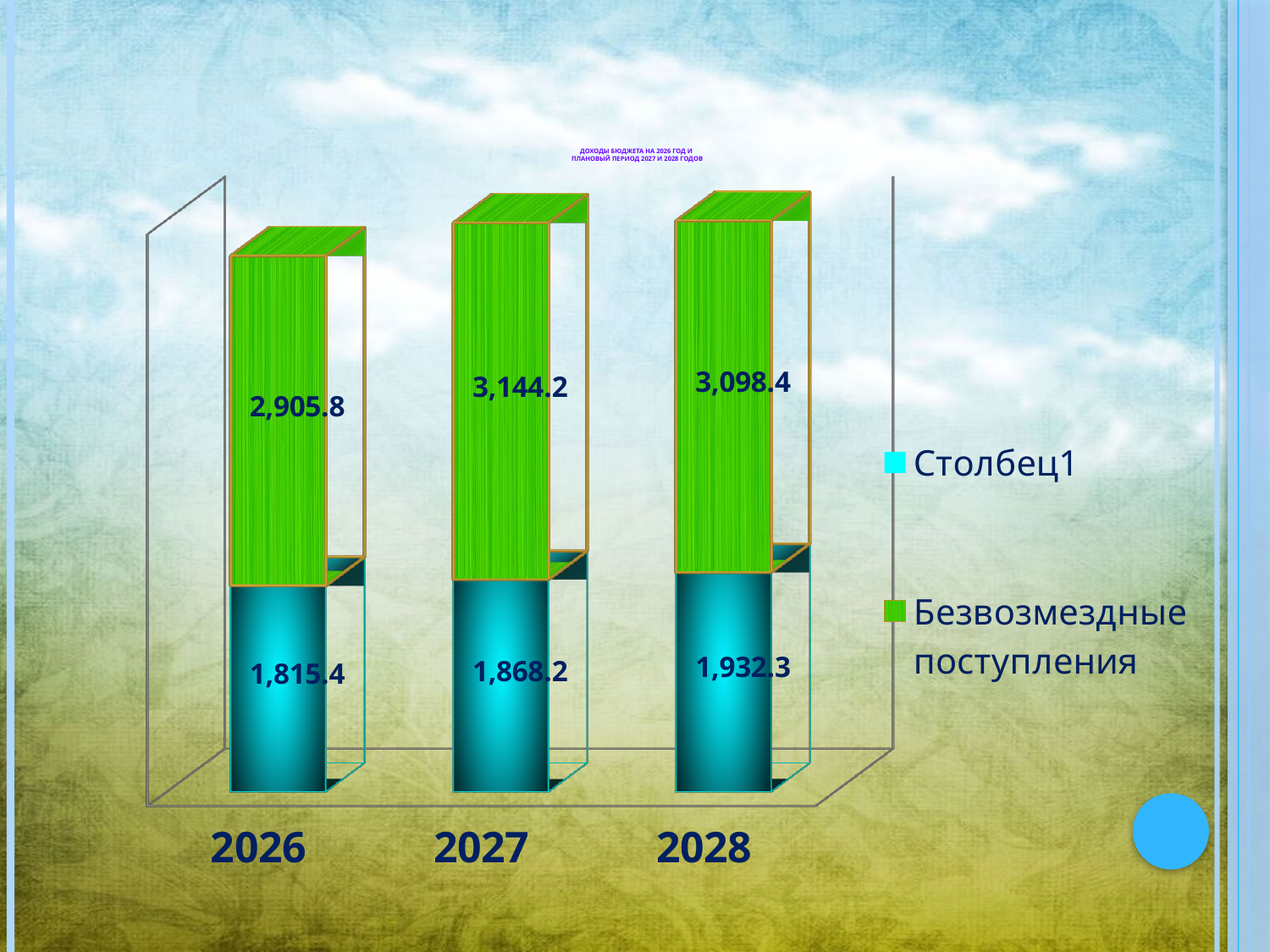
In which year is Безвозмездные поступления highest? 2027 What is the value of Столбец1 for 2028? 1,932.3 How many years are shown on the x axis? 3 What is the value of Безвозмездные поступления for 2028? 3,098.4 What is the value of Безвозмездные поступления for 2027? 3,144.2 Which is larger: Безвозмездные поступления in 2027 or in 2028? 2027 What is the difference between Безвозмездные поступления in 2027 and in 2026? 238.4 Does the value of Столбец1 rise or fall from 2026 to 2028? rise How many series does the legend list? 2 In which year is Столбец1 lowest? 2026 What is the value of Столбец1 for 2026? 1,815.4 What is the total of the stacked bar for 2026? 4,721.2